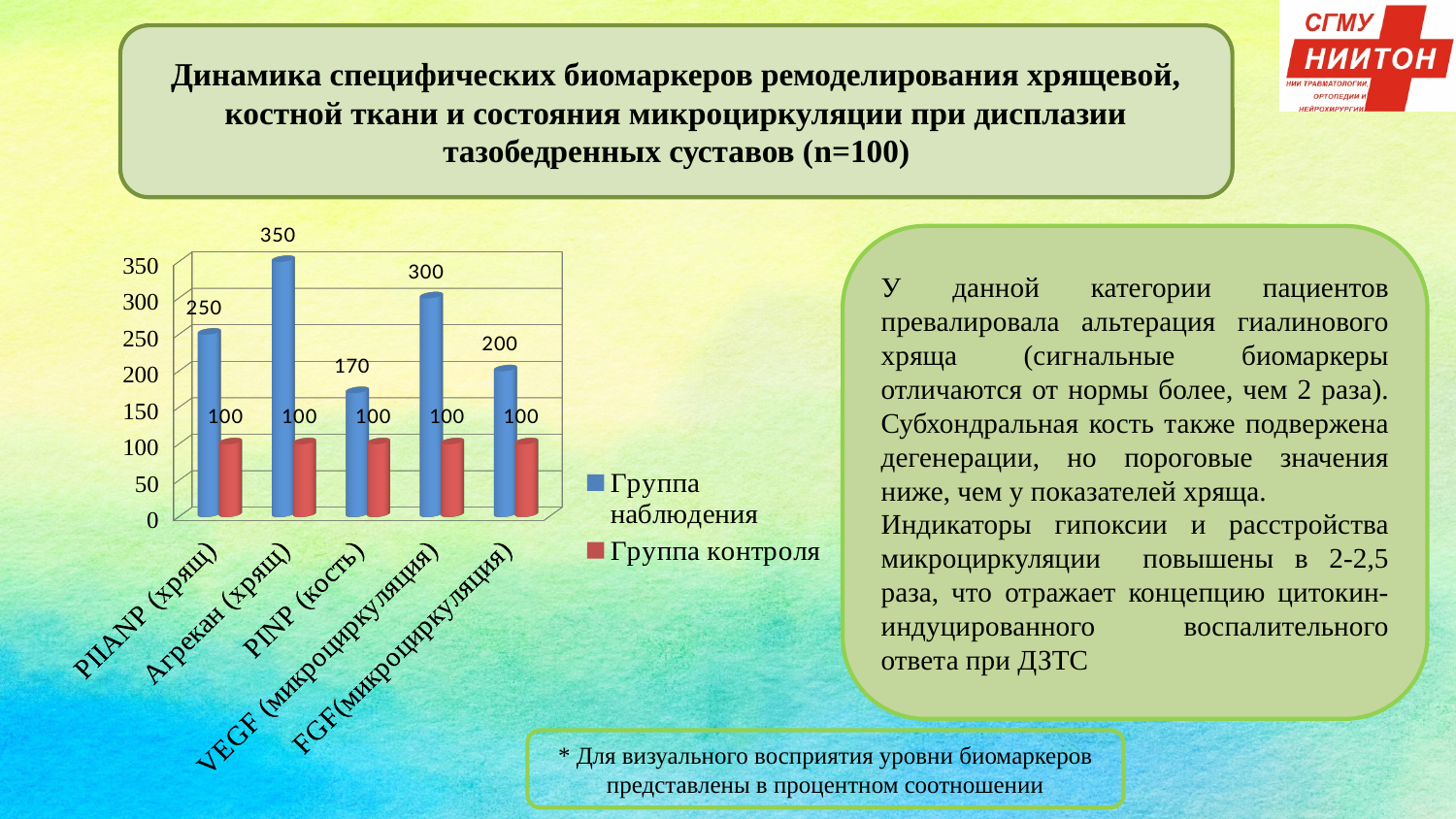
Which is larger in the Группа наблюдения series: VEGF (микроциркуляция) or FGF(микроциркуляция)? VEGF (микроциркуляция) What kind of chart is shown on the slide? Bar chart What is the value for Агрекан (хрящ) in the Группа наблюдения series? 350 What is the value for PINP (кость) in the Группа наблюдения series? 170 What is the value for VEGF (микроциркуляция) in the Группа наблюдения series? 300 What is the value for FGF(микроциркуляция) in the Группа контроля series? 100 How many categories are shown on the x axis of the chart? 5 How many series does the chart legend list? 2 Which category has the highest value in the Группа наблюдения series? Агрекан (хрящ) Which category has the lowest value in the Группа наблюдения series? PINP (кость) Which legend entry is shown in red? Группа контроля What is the difference between the Группа наблюдения and Группа контроля values for PIIANP (хрящ)? 150